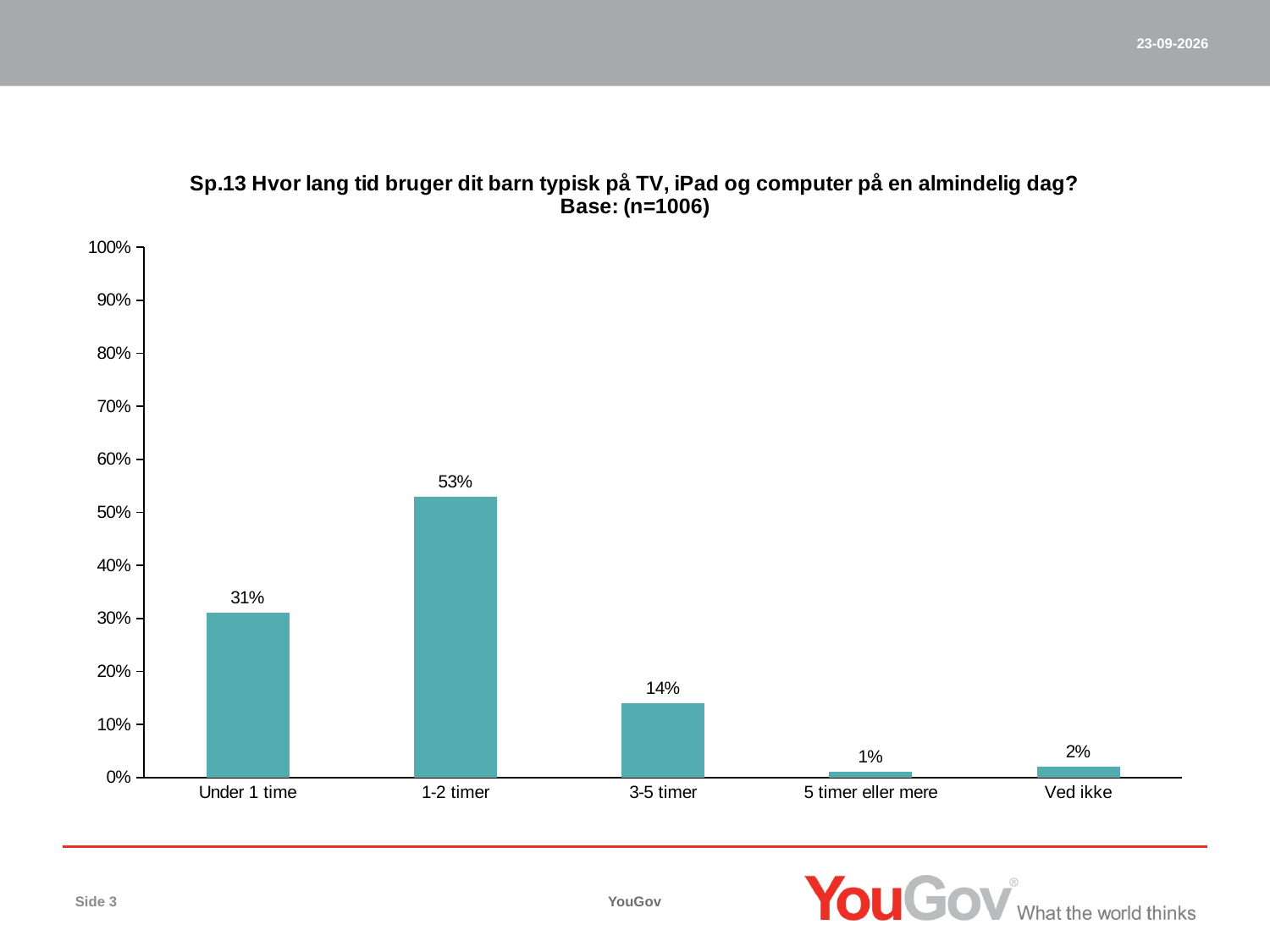
Which category has the lowest value? 5 timer eller mere Is the value for "1-2 timer" greater or less than 50%? greater What kind of chart is shown on the slide? Bar chart Which category has the highest value? 1-2 timer What is the value for "Ved ikke"? 2% Which is larger, the value for "3-5 timer" or the value for "Under 1 time"? Under 1 time What is the base size (n) stated in the chart title? n=1006 What is the difference between the values for "1-2 timer" and "Under 1 time"? 22% What is the value for "5 timer eller mere"? 1% How many categories are shown on the x axis? 5 What is the value for "Under 1 time"? 31% What is the value for "1-2 timer"? 53%